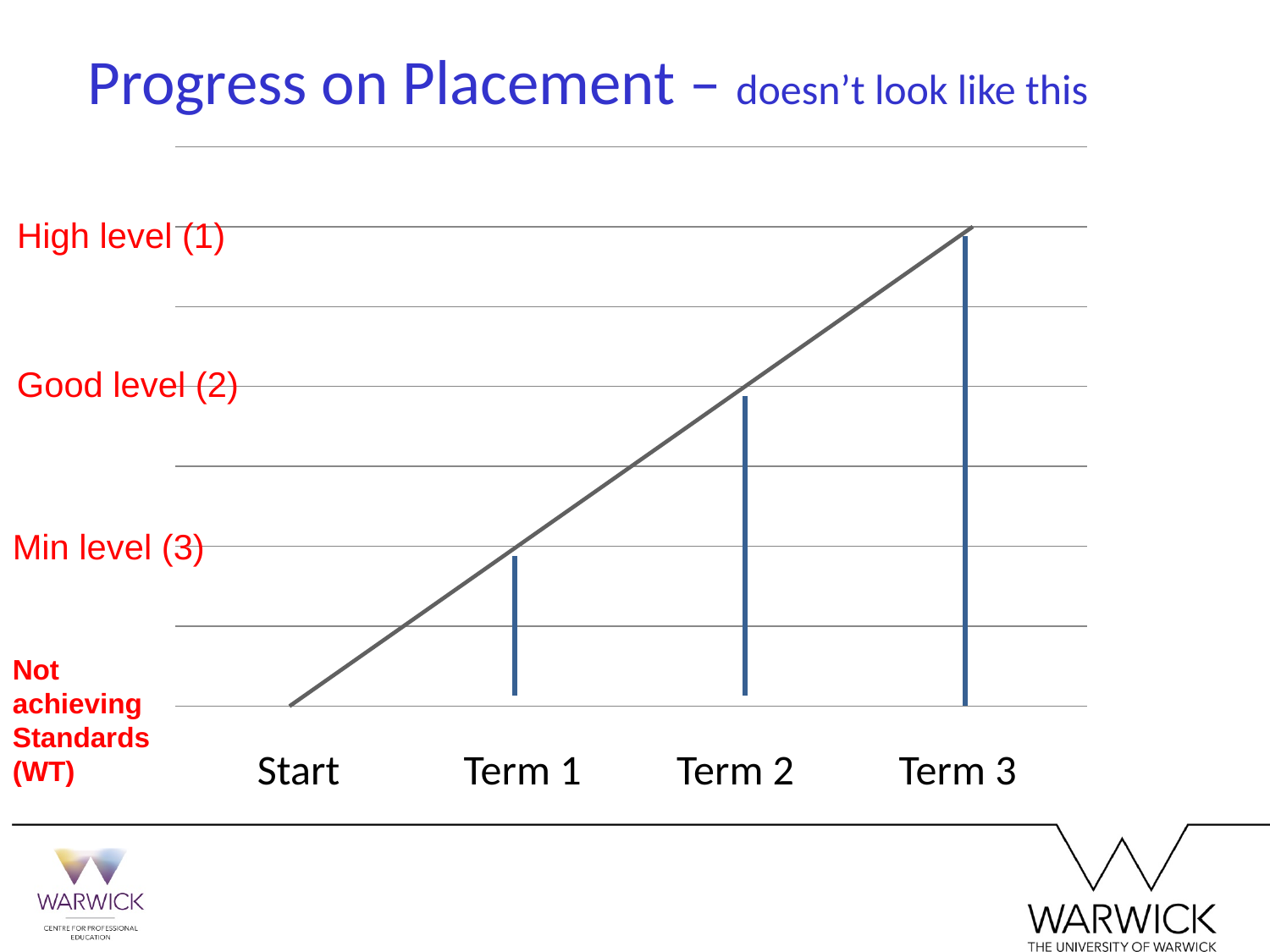
What is the title of the chart? Progress on Placement – doesn't look like this Which level label is at the bottom of the y axis? Not achieving Standards (WT) Do the bars rise or fall from Term 1 to Term 3? rise Which term has the tallest bar? Term 3 Which level does the bar for Term 1 reach? Min level (3) What kind of chart is shown on the slide? line chart Which term has the shortest bar? Term 1 Which level does the bar for Term 2 reach? Good level (2) How many categories are shown along the x axis? 4 Is the bar for Term 2 taller or shorter than the bar for Term 1? taller What are the categories along the x axis? Start, Term 1, Term 2, Term 3 Which level does the bar for Term 3 reach? High level (1)